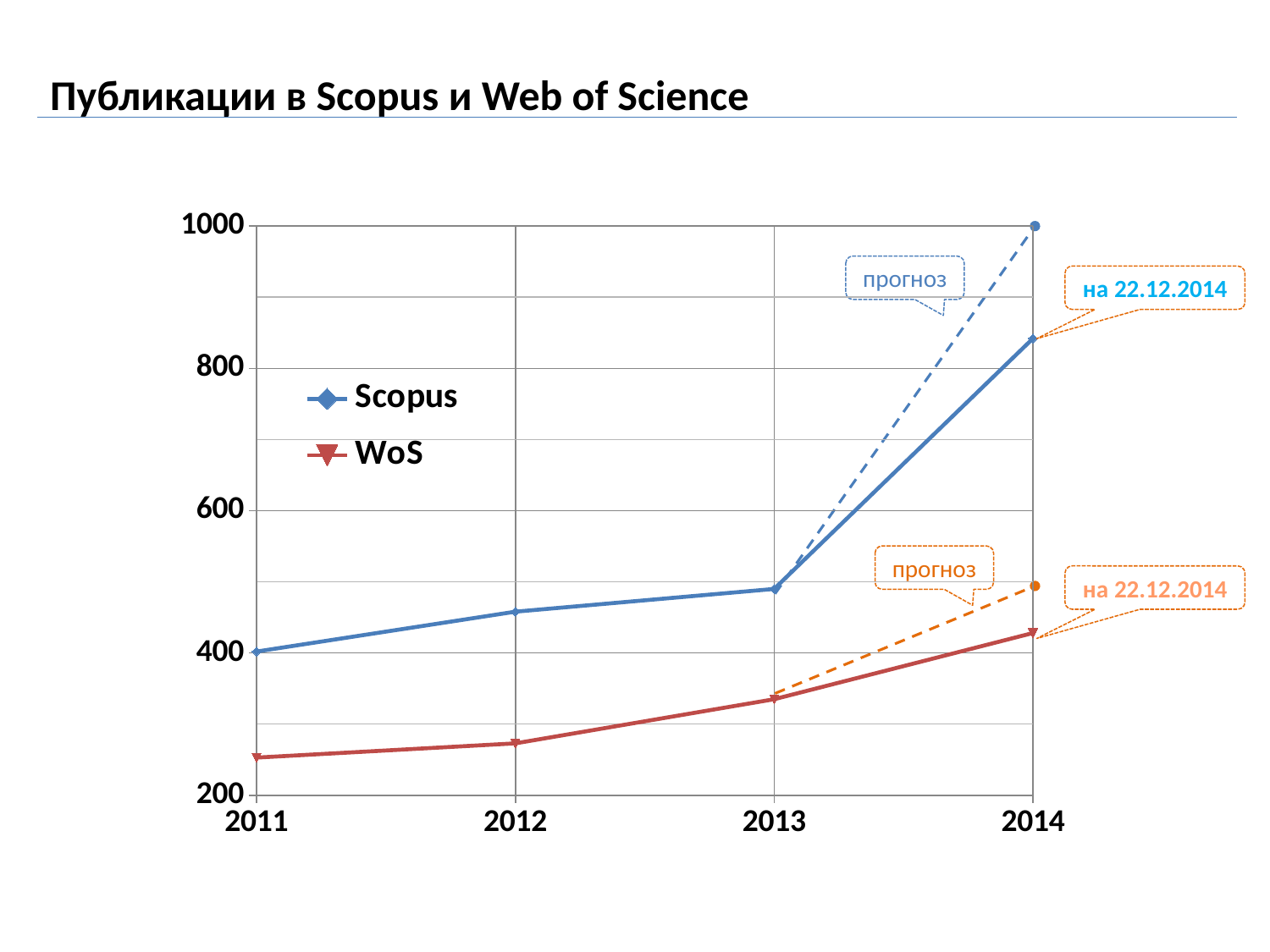
How many series does the legend list? 2 Is the value for WoS in 2014 (на 22.12.2014) greater or less than 400? greater Is the value for Scopus in 2013 greater or less than 600? less Is the value for WoS in 2013 greater or less than 400? less What is the title of the slide? Публикации в Scopus и Web of Science Which series has the higher value in 2013, Scopus or WoS? Scopus What kind of chart is shown on the slide? line chart Which two series are listed in the legend? Scopus and WoS How many years are shown on the x axis? 4 Do the values for WoS rise or fall from 2011 to 2014? rise